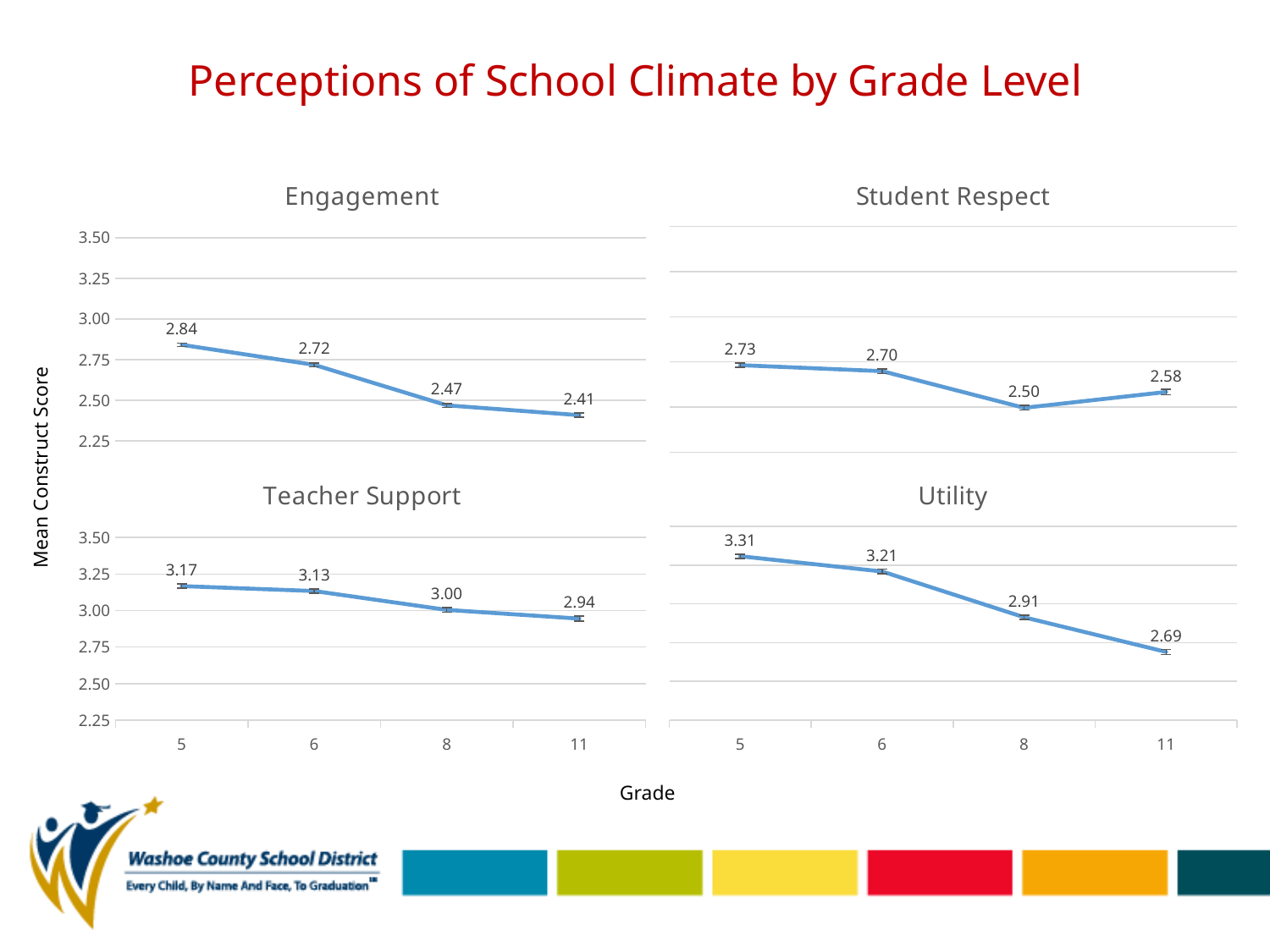
In the Utility chart, what is the difference between the grade 5 and grade 11 values? 0.62 How many grade levels are plotted in the Engagement chart? 4 What kind of chart is the Teacher Support chart? Line chart In the Student Respect chart, which is larger, the value for grade 8 or grade 11? Grade 11 In the Utility chart, do the values rise or fall as grade level increases? Fall In the Teacher Support chart, is the value for grade 5 greater or less than 3.00? greater In the Teacher Support chart, what is the value for grade 11? 2.94 In the Student Respect chart, what is the value for grade 8? 2.50 In the Engagement chart, which grade has the lowest value? 11 In the Utility chart, which grade has the highest value? 5 In the Utility chart, what is the value for grade 6? 3.21 In the Engagement chart, what is the mean construct score for grade 5? 2.84